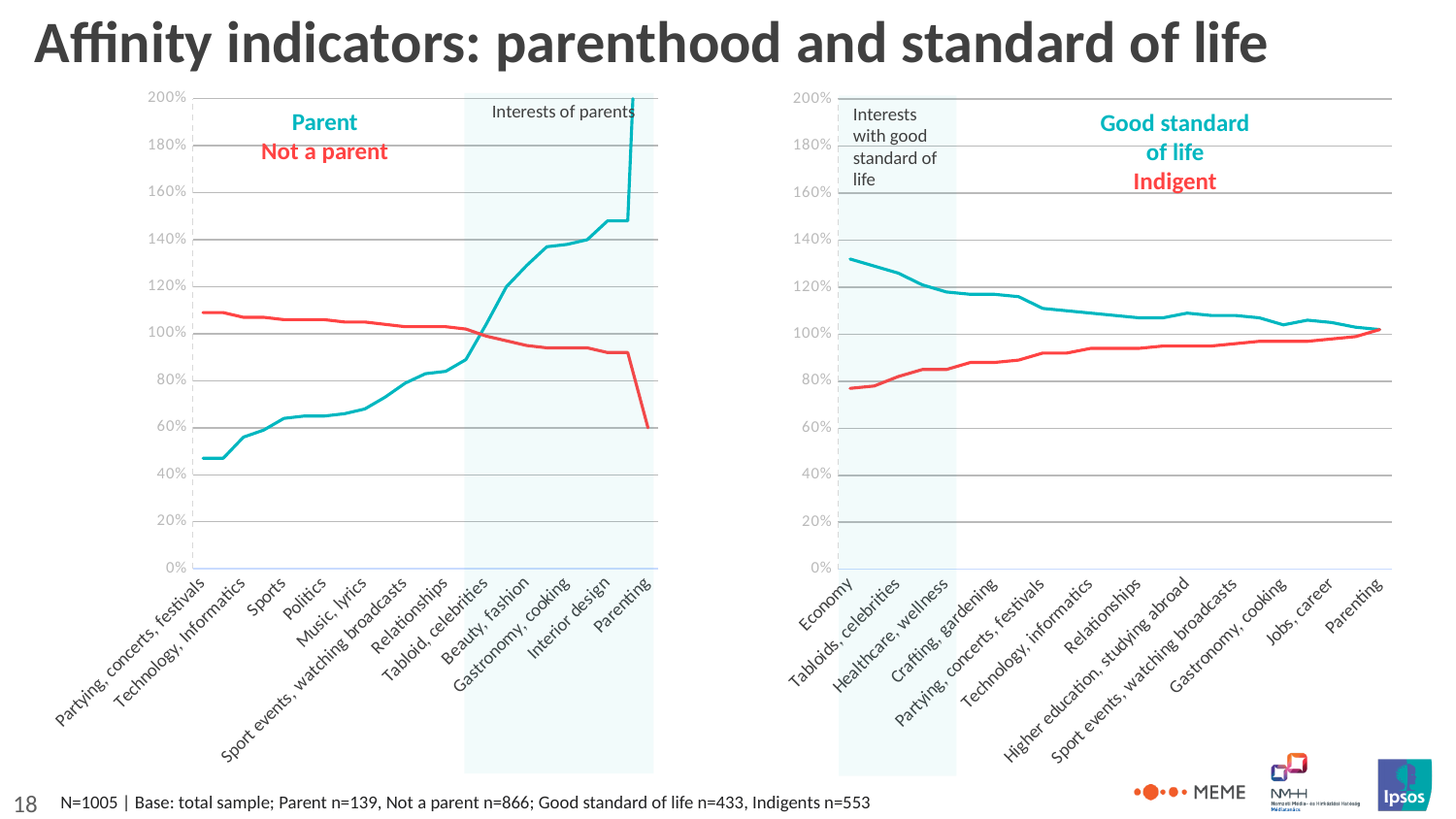
In the right chart, is the Good standard of life value for Economy greater or less than 120%? greater In the right chart, which category has the highest Good standard of life value? Economy How many series does the right chart (Good standard of life / Indigent) show? 2 In the left chart, does the Parent line rise or fall along the x axis from Partying, concerts, festivals to Parenting? rise In the left chart, at Sports, which series has the larger value: Parent or Not a parent? Not a parent What kind of chart is the left chart on the slide? line chart In the left chart, is the Not a parent value for Partying, concerts, festivals greater or less than 100%? greater In the right chart, does the Indigent line rise or fall along the x axis from Economy to Parenting? rise In the left chart, which category has the lowest Parent value? Partying, concerts, festivals In the left chart, is the Parent value for Partying, concerts, festivals greater or less than 60%? less